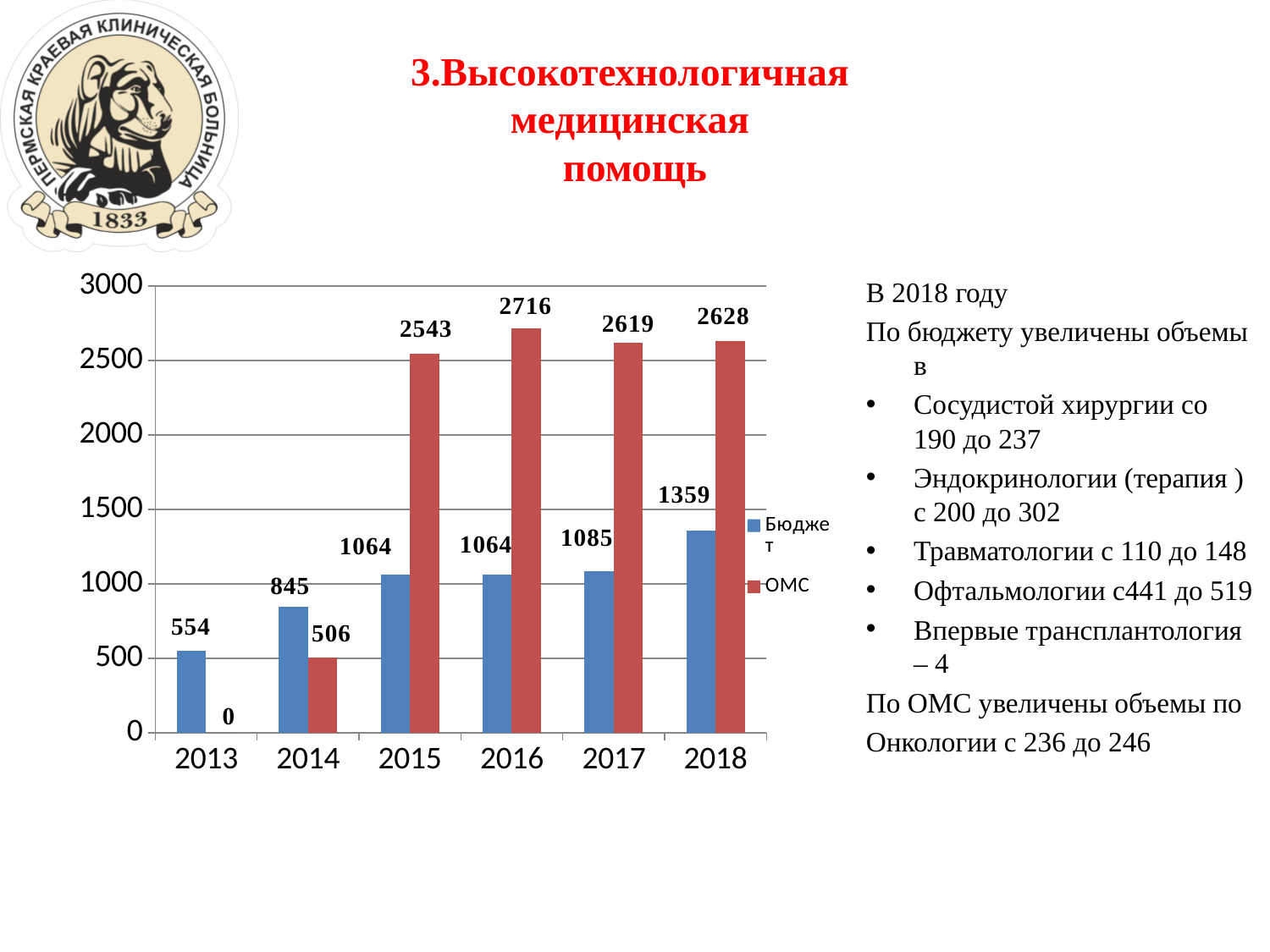
What colour are the ОМС bars? Red Which is larger in 2014, Бюджет or ОМС? Бюджет What is the value of ОМС for 2016? 2716 What kind of chart is shown on the slide? Bar chart Which year has the highest ОМС value? 2016 What is the value of Бюджет for 2018? 1359 What is the value of ОМС for 2013? 0 Does the Бюджет value rise or fall from 2013 to 2018? Rise How many series does the legend list? 2 How many years are shown on the x axis? 6 Which year has the lowest Бюджет value? 2013 What is the difference between the ОМС and Бюджет values in 2018? 1269